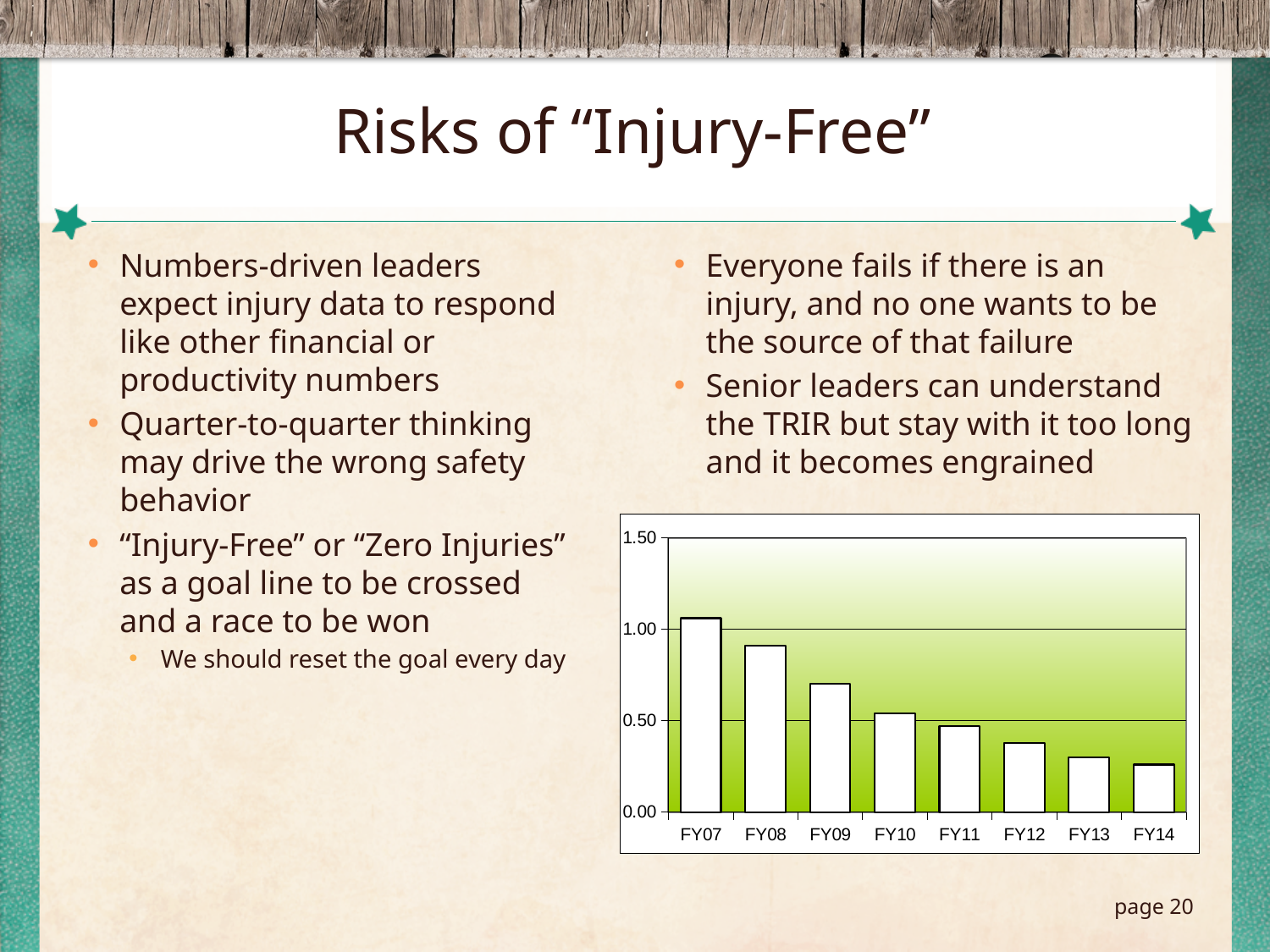
Which fiscal year has the highest bar in the chart? FY07 What kind of chart is shown on the slide? bar chart Which is larger, the value for FY09 or the value for FY12? FY09 Which fiscal year has the lowest bar in the chart? FY14 What is the highest tick value shown on the chart's vertical axis? 1.50 Is the value for FY08 greater or less than 1.00? less How many fiscal years are plotted in the chart? 8 Is the value for FY09 greater or less than 0.50? greater Do the values rise or fall from FY07 to FY14? fall Is the value for FY14 greater or less than 0.50? less